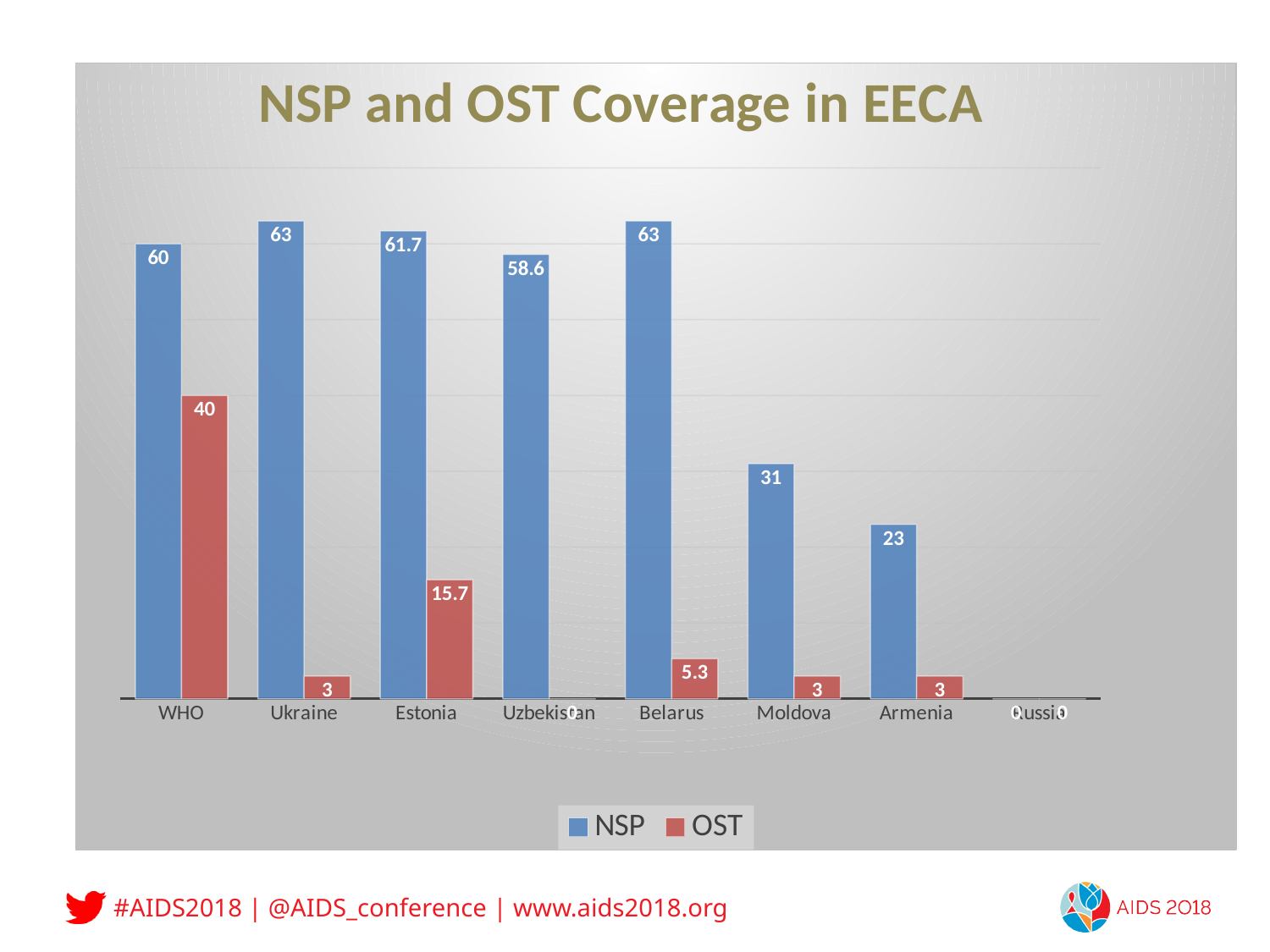
What is the NSP coverage value for Estonia? 61.7 What kind of chart is shown on the slide? Bar chart What is the difference between the NSP values for Ukraine and Moldova? 32 Which category has the highest OST coverage value? WHO Which category has the lowest NSP coverage value? Russia How many categories are shown on the x axis? 8 How many series does the legend list? 2 What is the OST coverage value for WHO? 40 What is the difference between the NSP and OST values for WHO? 20 Which has a larger NSP coverage value, Moldova or Armenia? Moldova What is the NSP coverage value for Uzbekistan? 58.6 What is the OST coverage value for Belarus? 5.3